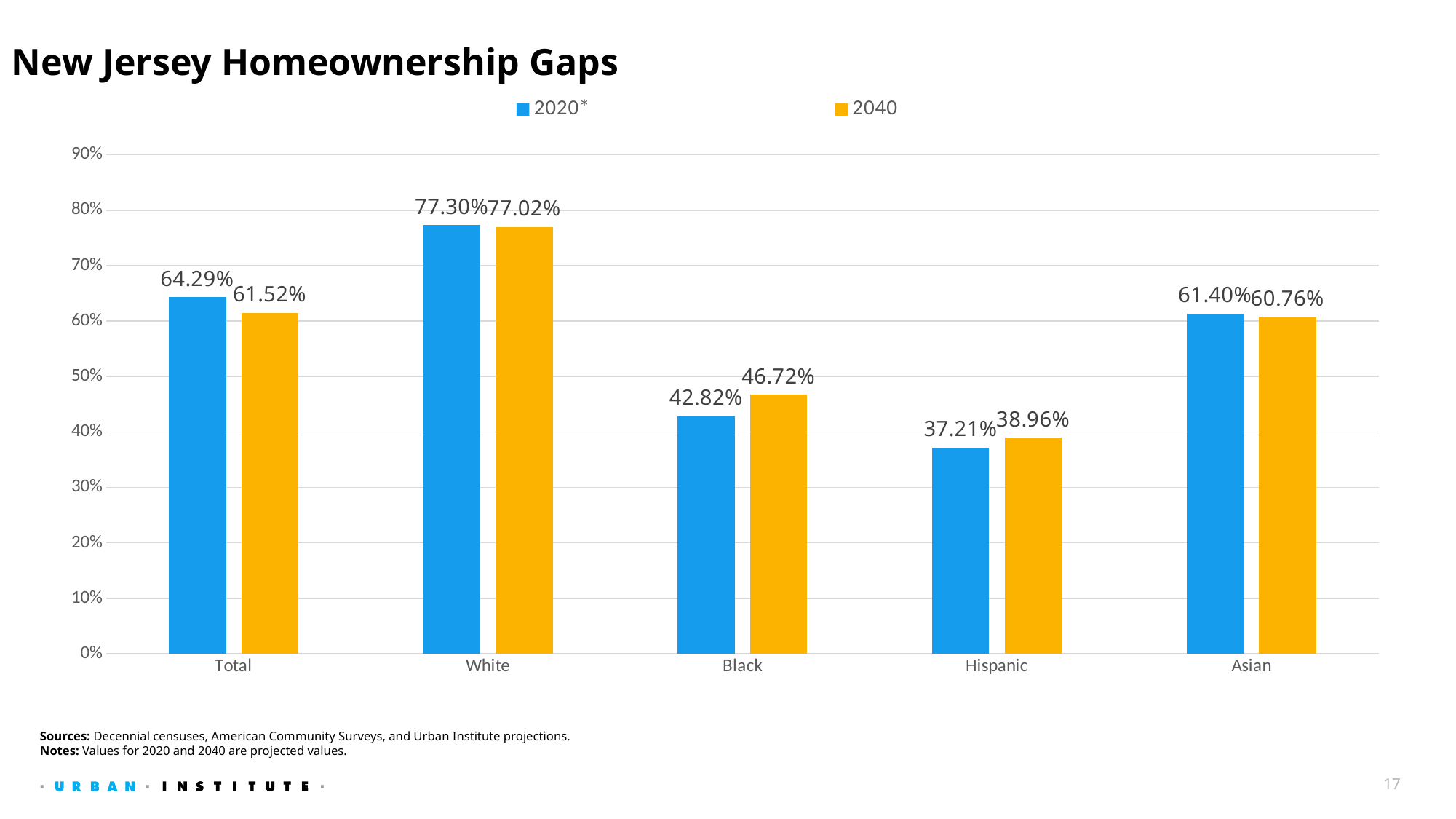
What is the 2020 homeownership rate for Black households? 42.82% Which colour represents the 2040 series? Orange Which category has the highest 2020 homeownership rate? White Which category has the lowest 2040 homeownership rate? Hispanic What is the difference between the 2040 and 2020 values for Black households? 3.90% What is the 2040 value for the Total category? 61.52% What kind of chart is shown on the slide? Bar chart What is the 2040 homeownership rate for Hispanic households? 38.96% How many series does the legend list? 2 What is the title of the chart? New Jersey Homeownership Gaps Which is larger for Asian households, the 2020 value or the 2040 value? 2020 How many categories are shown on the x axis? 5